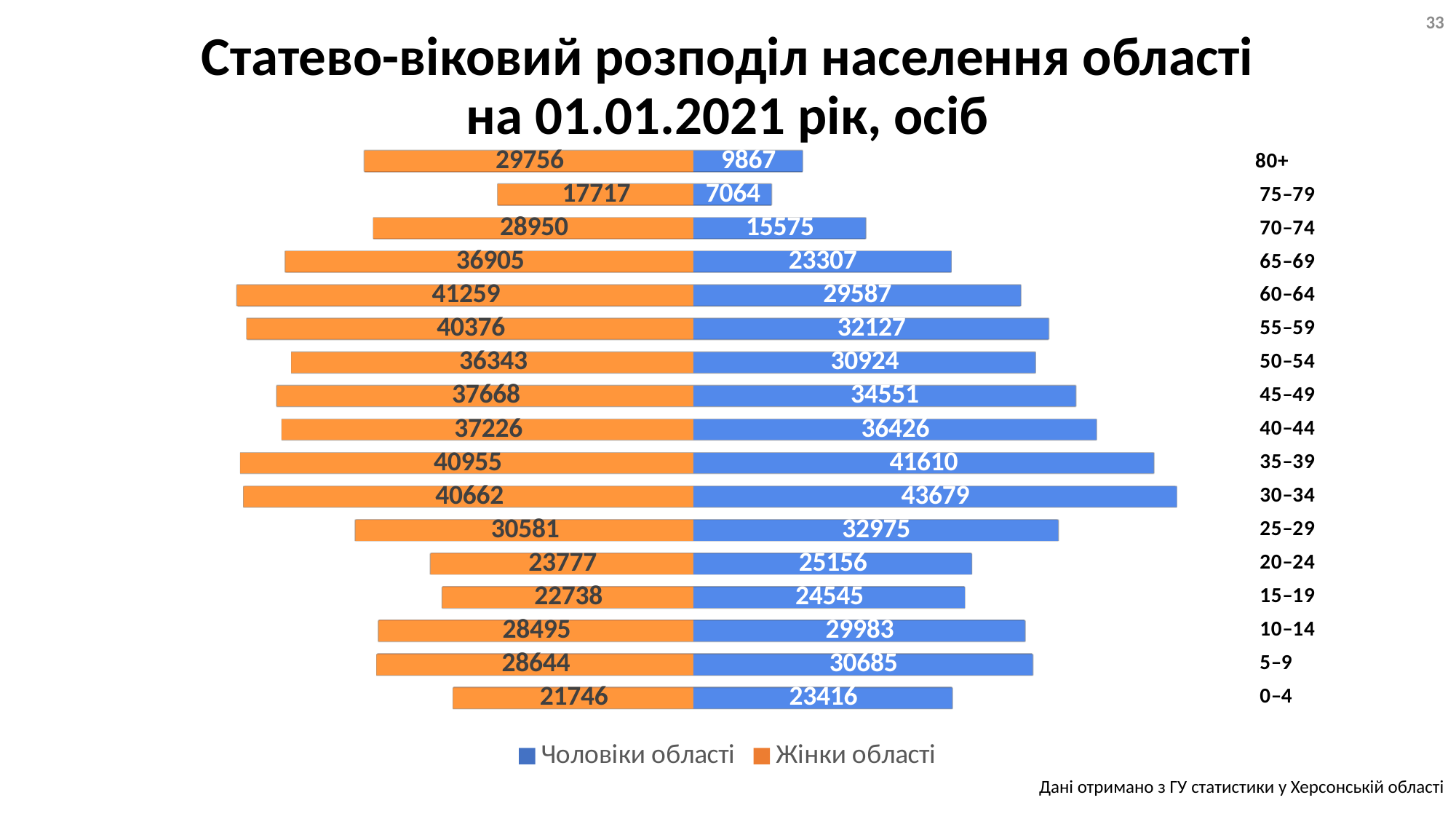
What is the value for Жінки області in the 60–64 age group? 41259 What is the value for Чоловіки області in the 80+ age group? 9867 How many age groups are shown in the chart? 17 In the 35–39 age group, which series has the larger value, Чоловіки області or Жінки області? Чоловіки області What is the difference between Жінки області and Чоловіки області in the 80+ age group? 19889 What is the total of Чоловіки області and Жінки області in the 30–34 age group? 84341 How many series does the legend list? 2 What is the value for Чоловіки області in the 0–4 age group? 23416 What type of chart is shown on the slide? bar chart Which age group has the lowest value for Чоловіки області? 75–79 Which age group has the highest value for Чоловіки області? 30–34 Which age group has the lowest value for Жінки області? 75–79